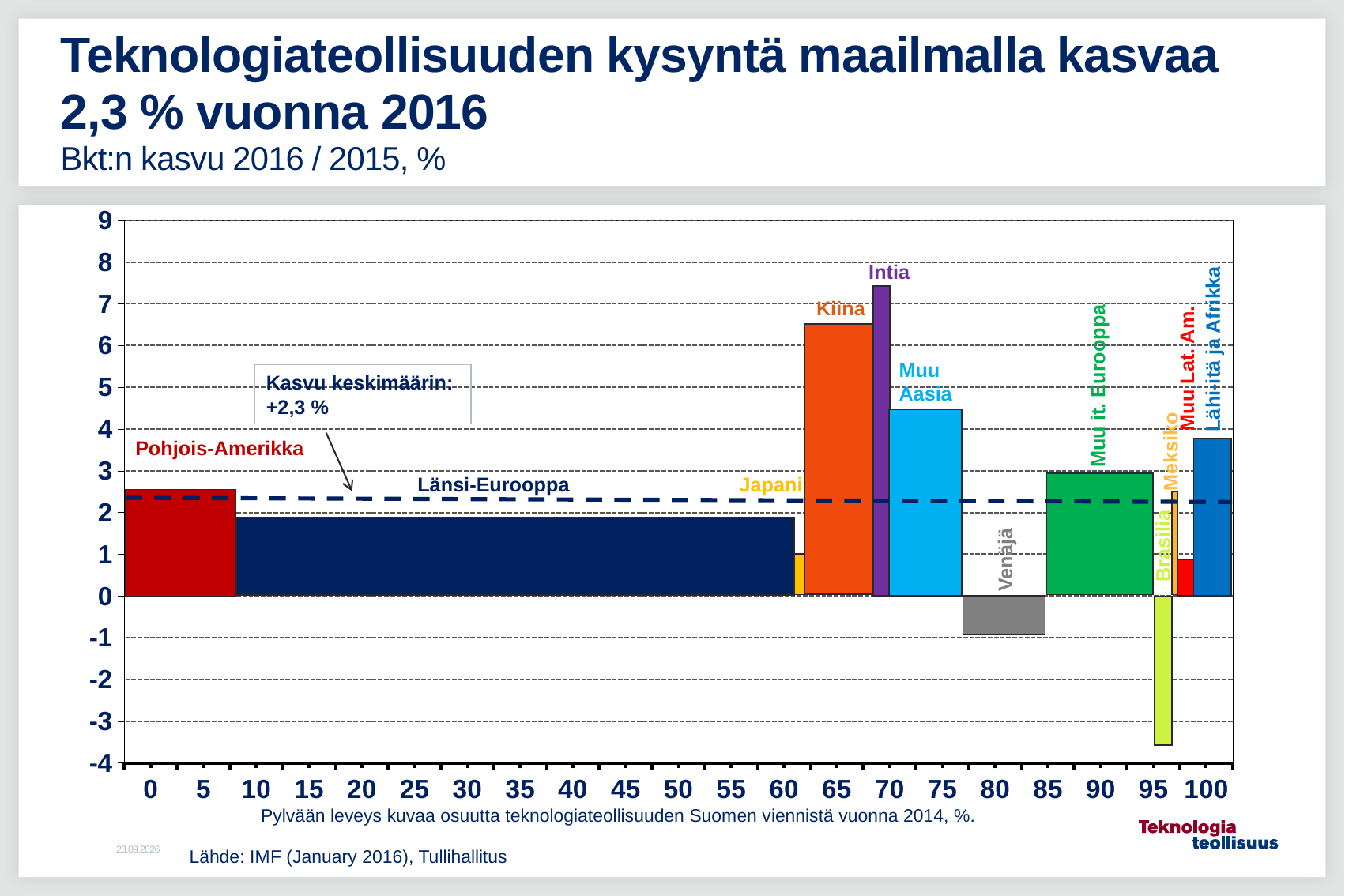
Is the value for Kiina greater or less than 6? greater Is the value for Intia greater or less than 7? greater How many regions (bars) are shown in the chart? 12 Which has the larger value, Kiina or Muu Aasia? Kiina Which region has the lowest GDP growth in the chart? Brasilia What kind of chart is shown on the slide? bar chart Which region has the highest GDP growth in the chart? Intia Is the value for Brasilia greater or less than -3? less What is the subtitle describing the measure plotted in the chart? Bkt:n kasvu 2016 / 2015, % What average growth value is shown in the annotation box on the chart? +2,3 %